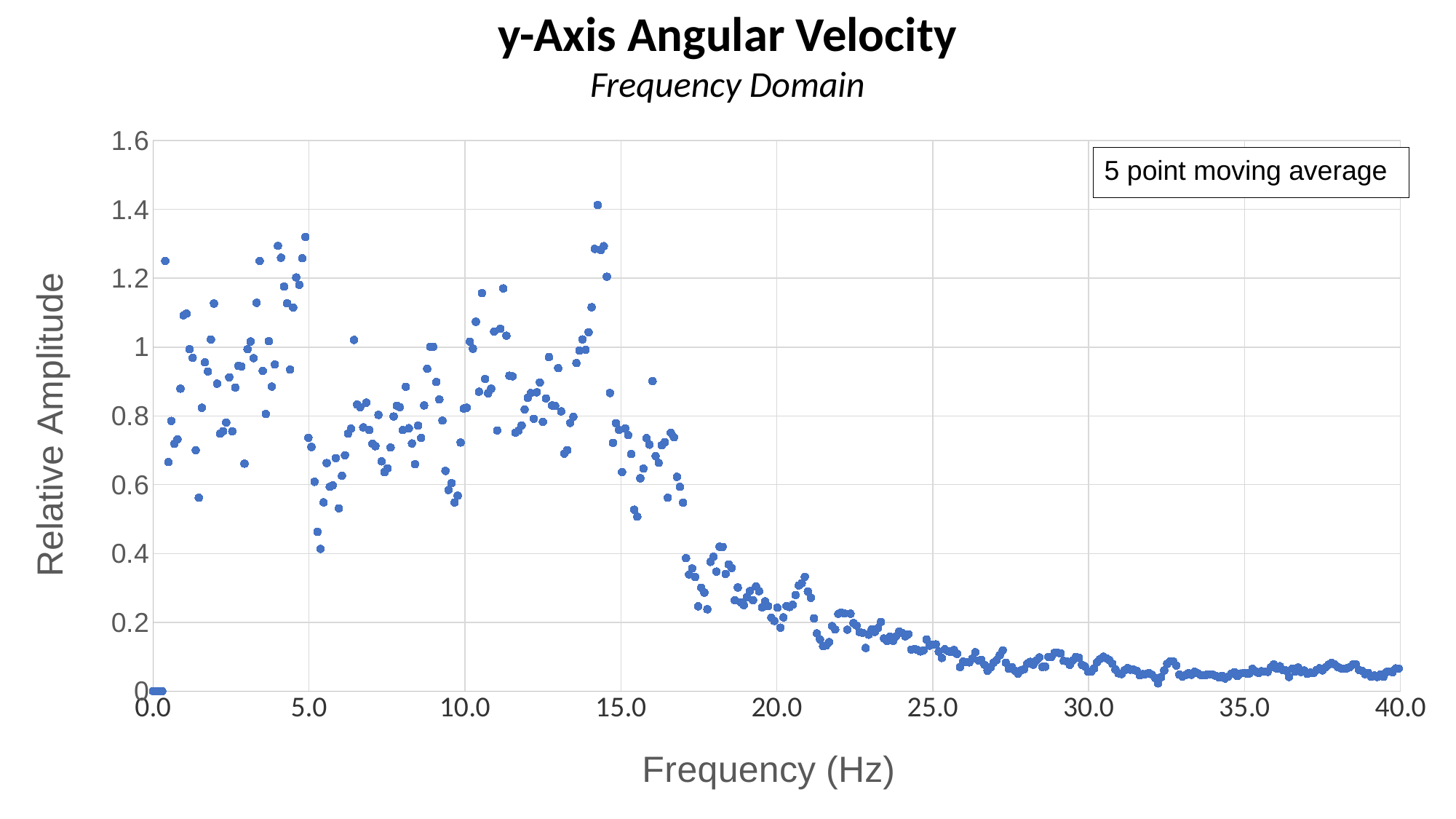
Are the plotted values around 20.0 Hz greater or less than 0.6? less What is the subtitle shown under the chart title? Frequency Domain Are the plotted values around 30.0 Hz greater or less than 0.4? less Is the highest plotted point, near 14 Hz, greater or less than 1.2? greater What kind of chart is shown on the slide? scatter plot What is the title of the chart? y-Axis Angular Velocity Which is larger: the plotted values around 10.0 Hz or the plotted values around 30.0 Hz? around 10.0 Hz What is the maximum value shown on the x axis (Frequency)? 40.0 Overall, do the plotted values rise or fall as frequency increases from 0 to 40 Hz? fall